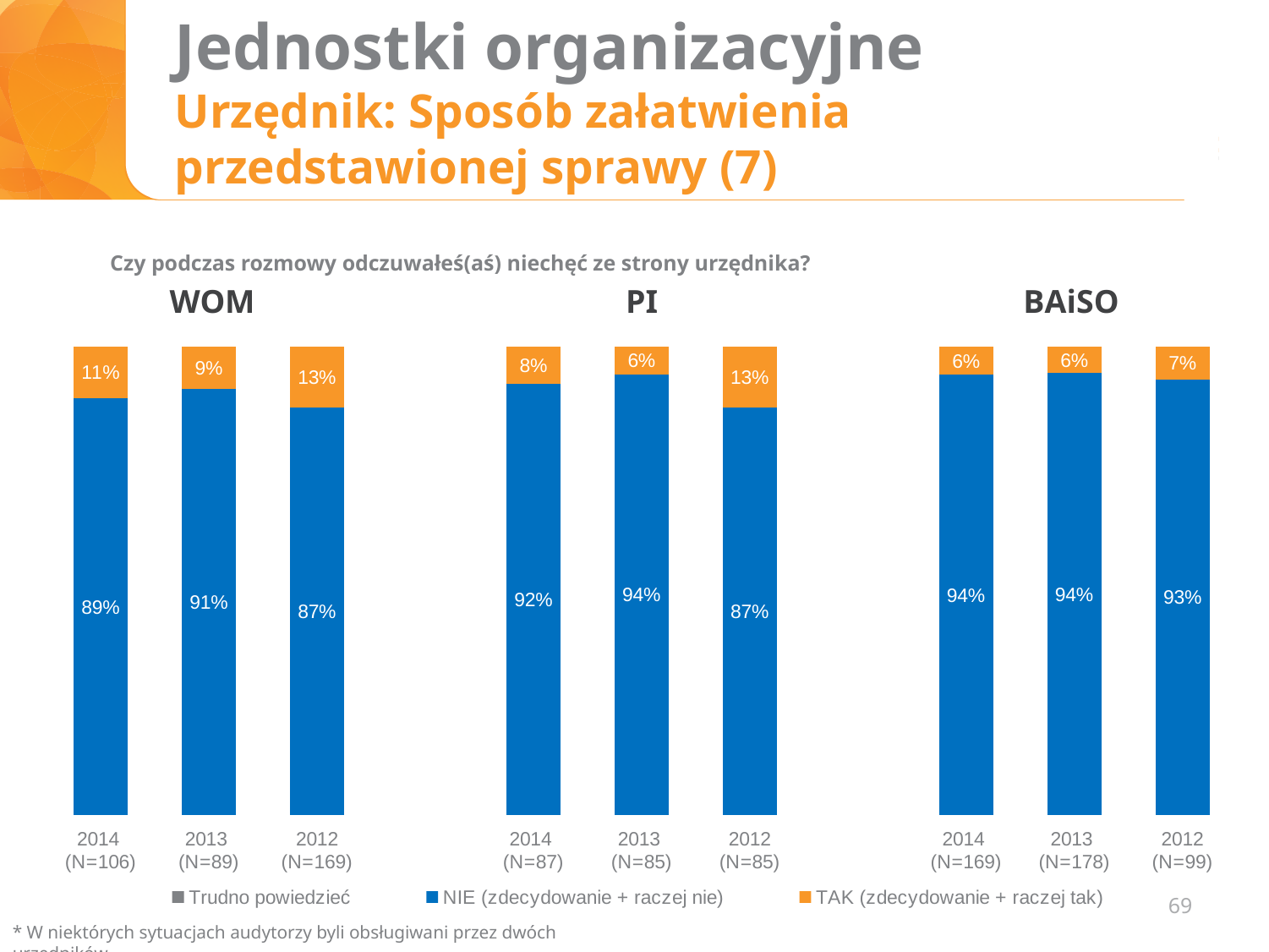
How many series does the legend list? 3 In the PI chart, which year has the lowest NIE (zdecydowanie + raczej nie) value? 2012 In the PI chart, what is the difference between the TAK values for 2012 and 2013? 7% In the WOM chart, which year has the highest NIE (zdecydowanie + raczej nie) value? 2013 In the BAiSO chart, what is the TAK (zdecydowanie + raczej tak) value for 2012 (N=99)? 7% In the BAiSO chart, what is the total of the 2014 (N=169) bar? 100% What kind of chart is the PI chart? Stacked bar chart In the WOM chart, what is the TAK (zdecydowanie + raczej tak) value for 2012 (N=169)? 13% In the WOM chart, what is the NIE (zdecydowanie + raczej nie) value for 2014 (N=106)? 89% How many bars does the BAiSO chart show? 3 In the WOM chart, which is larger: the TAK value for 2014 or the TAK value for 2013? 2014 In the PI chart, what is the NIE (zdecydowanie + raczej nie) value for 2013 (N=85)? 94%